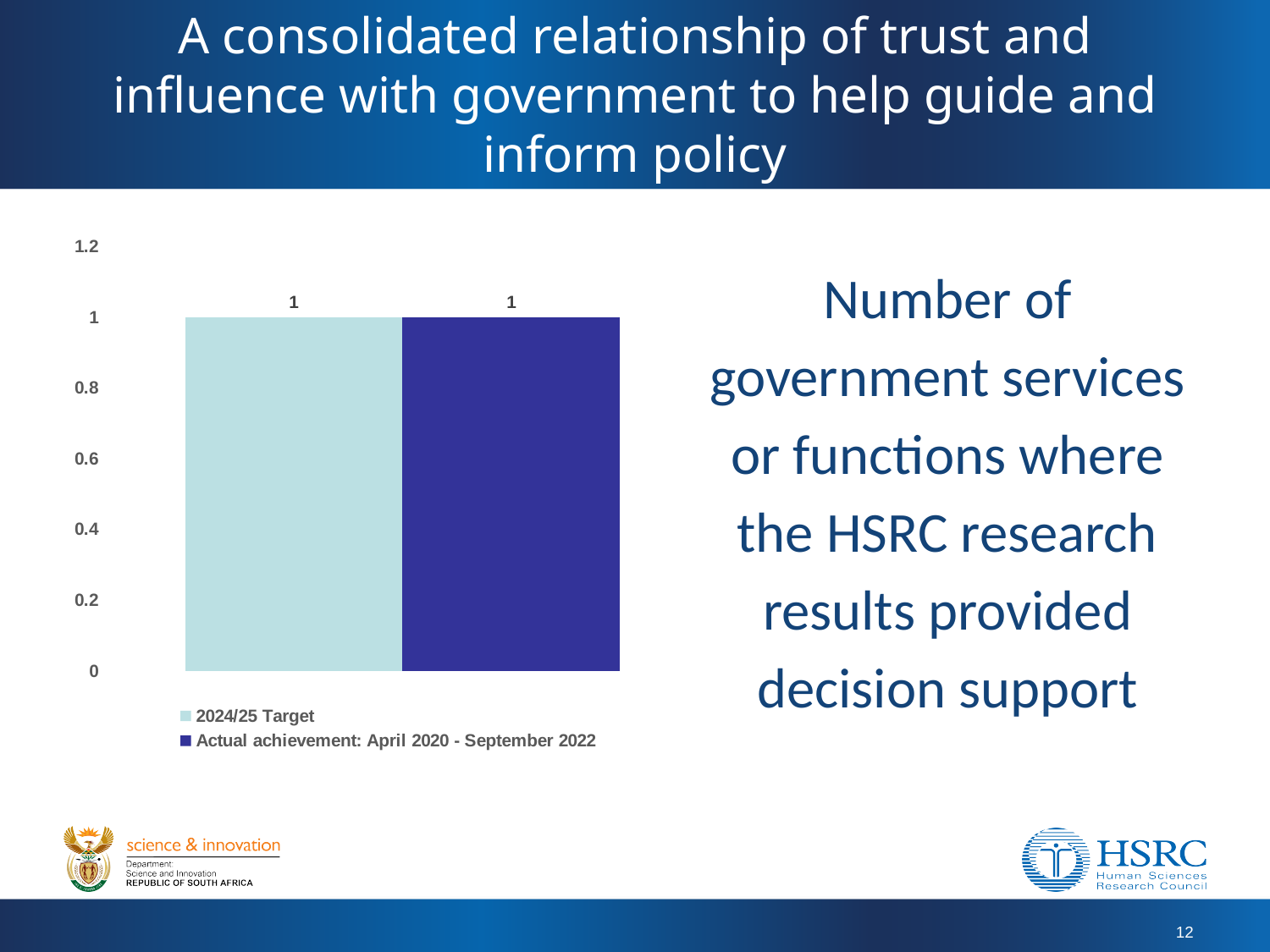
How many series does the legend list? 2 What is the value for the 2024/25 Target? 1 What is the value for Actual achievement: April 2020 - September 2022? 1 What is the difference between the 2024/25 Target and the Actual achievement: April 2020 - September 2022? 0 Which legend entry is shown in dark blue? Actual achievement: April 2020 - September 2022 Is the value for the 2024/25 Target greater or less than 0.8? greater How many bars are plotted in the chart? 2 What is the highest value shown on the vertical axis? 1.2 Is the value for Actual achievement: April 2020 - September 2022 greater or less than 1.2? less What kind of chart is shown on the slide? bar chart